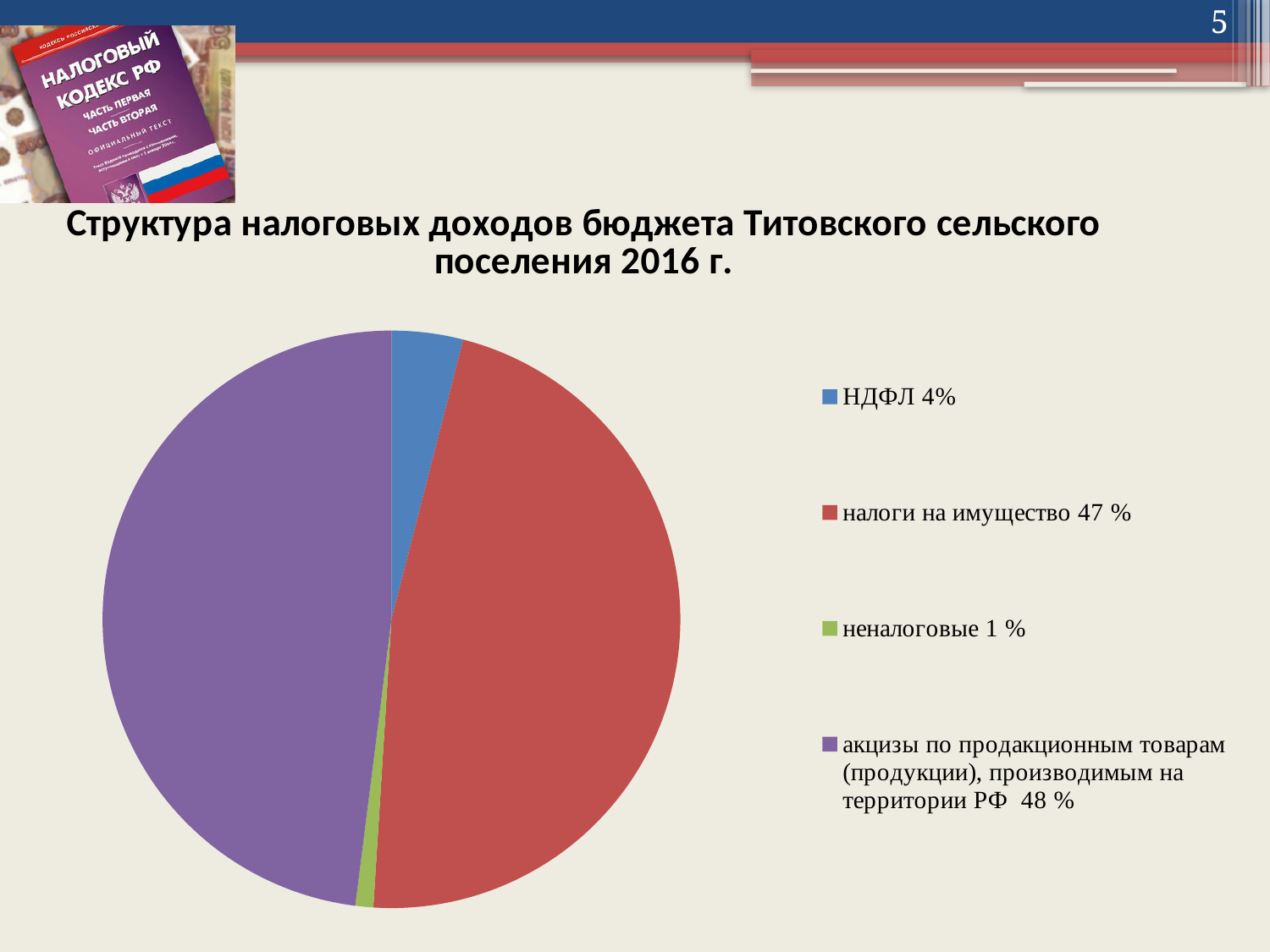
What is the difference in percentage points between the share for налоги на имущество and the share for НДФЛ? 43 What share is shown for акцизы по продакционным товарам (продукции), производимым на территории РФ? 48 % Which category has the largest share of the pie? акцизы по продакционным товарам (продукции), производимым на территории РФ What share is shown for неналоговые revenues? 1 % What share of tax revenues does НДФЛ account for? 4% Which category has the smallest share of the pie? неналоговые What colour is the slice for налоги на имущество? red What share is shown for налоги на имущество? 47 % What is the title of the chart on the slide? Структура налоговых доходов бюджета Титовского сельского поселения 2016 г. How many slices does the pie chart have? 4 What kind of chart is shown on the slide? pie chart Which is larger: the share for НДФЛ or the share for неналоговые? НДФЛ